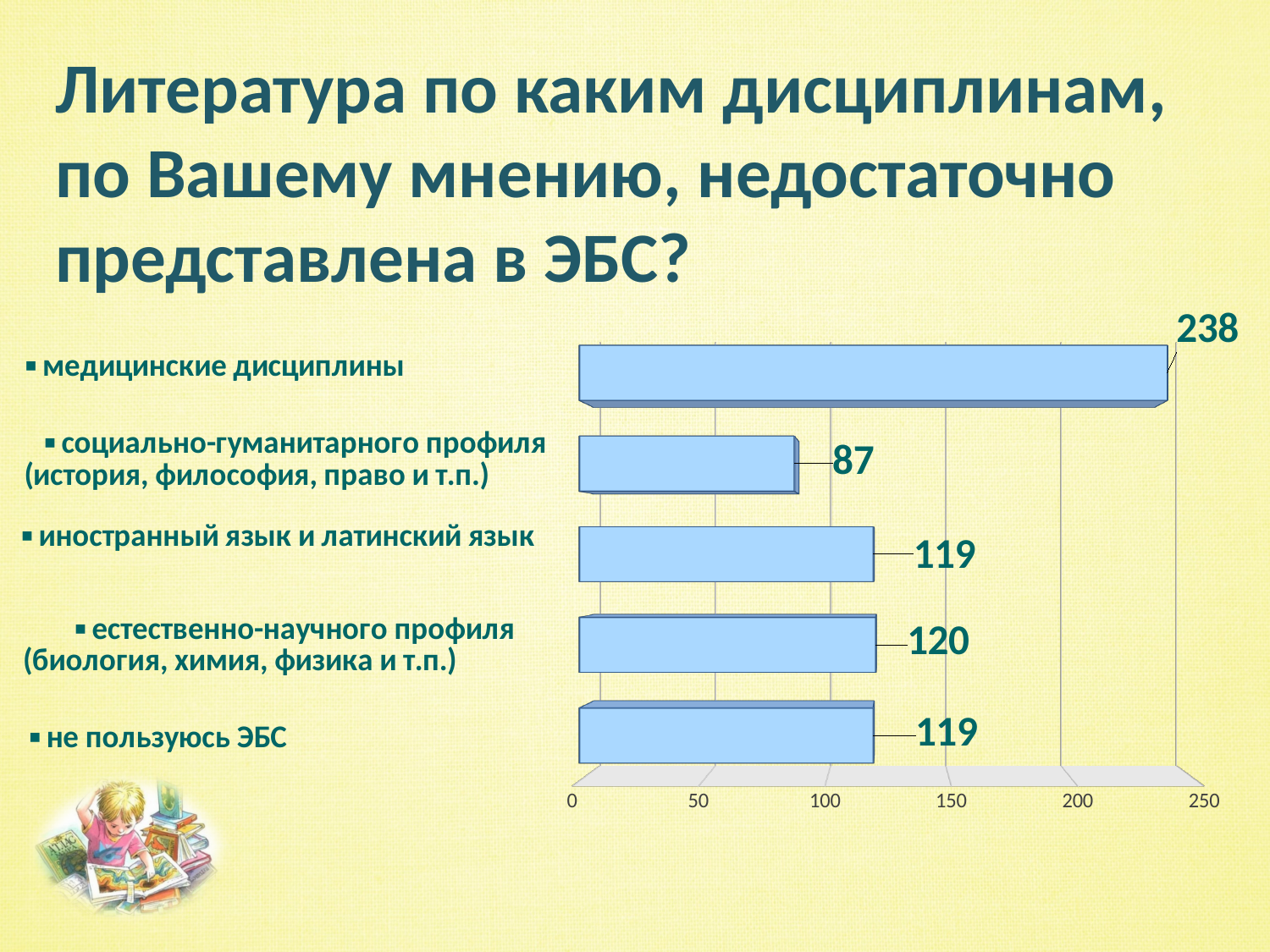
Which category has the lowest value? социально-гуманитарного профиля (история, философия, право и т.п.) Which is larger: the value for "медицинские дисциплины" or the value for "естественно-научного профиля"? медицинские дисциплины What is the value for "иностранный язык и латинский язык"? 119 What is the difference between the values for "медицинские дисциплины" and "социально-гуманитарного профиля"? 151 How many categories does the chart show? 5 What is the value for "естественно-научного профиля (биология, химия, физика и т.п.)"? 120 Is the value for "социально-гуманитарного профиля" greater or less than 100? less Which category has the highest value? медицинские дисциплины What is the value for "социально-гуманитарного профиля (история, философия, право и т.п.)"? 87 What is the value for "медицинские дисциплины"? 238 What is the value for "не пользуюсь ЭБС"? 119 What kind of chart is shown on the slide? bar chart